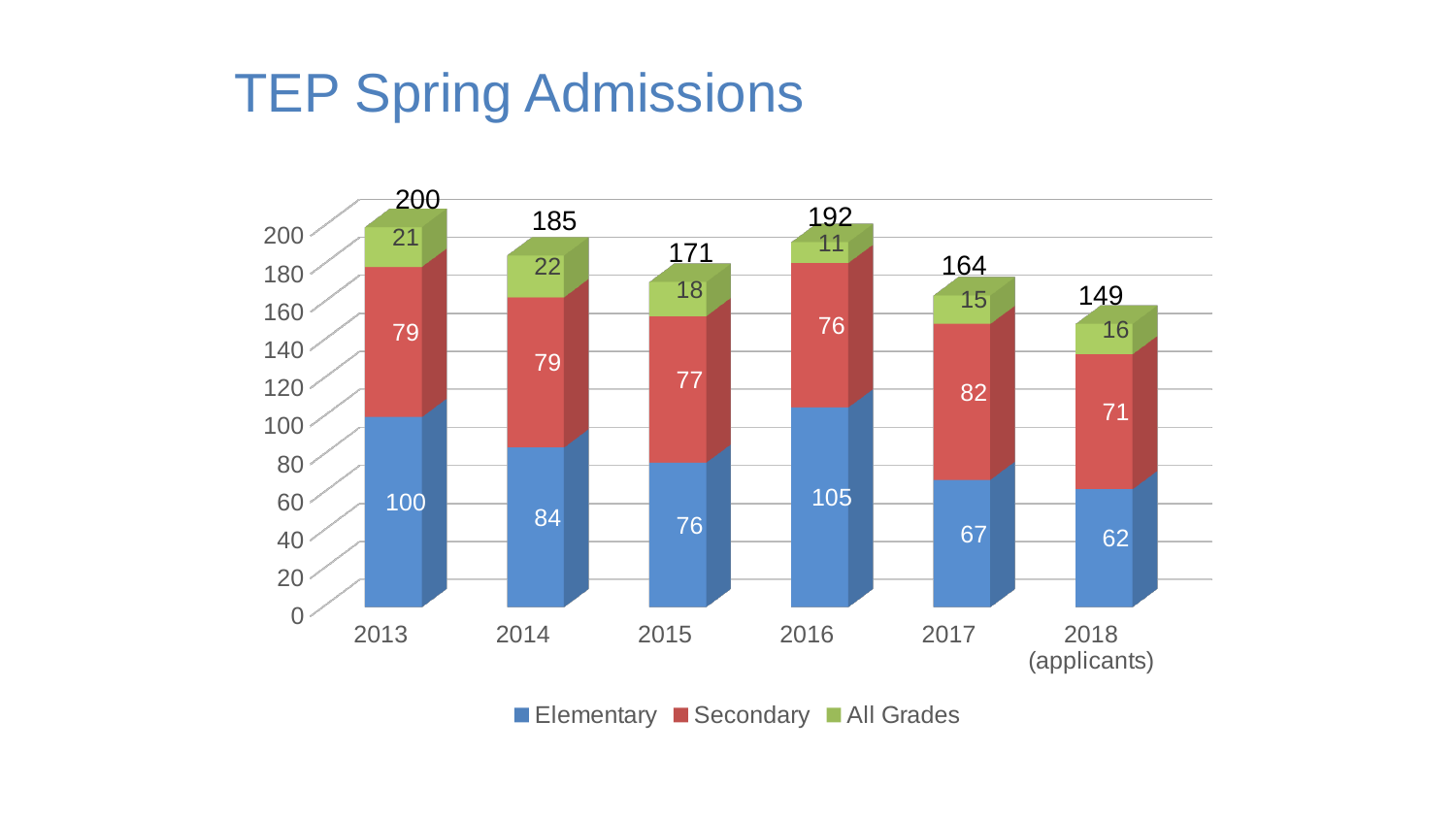
Which is larger, the Secondary value for 2016 or the Secondary value for 2018? 2016 What is the Secondary value for 2017? 82 What is the total of the stacked bar for 2015? 171 How many series does the legend list? 3 Which year has the highest total? 2013 What is the difference between the Elementary values for 2013 and 2018? 38 Which year has the lowest Elementary value? 2018 (applicants) How many categories are shown on the x axis? 6 What kind of chart is shown? Stacked bar chart What is the title of the chart? TEP Spring Admissions What is the All Grades value for 2014? 22 What is the Elementary value for 2016? 105